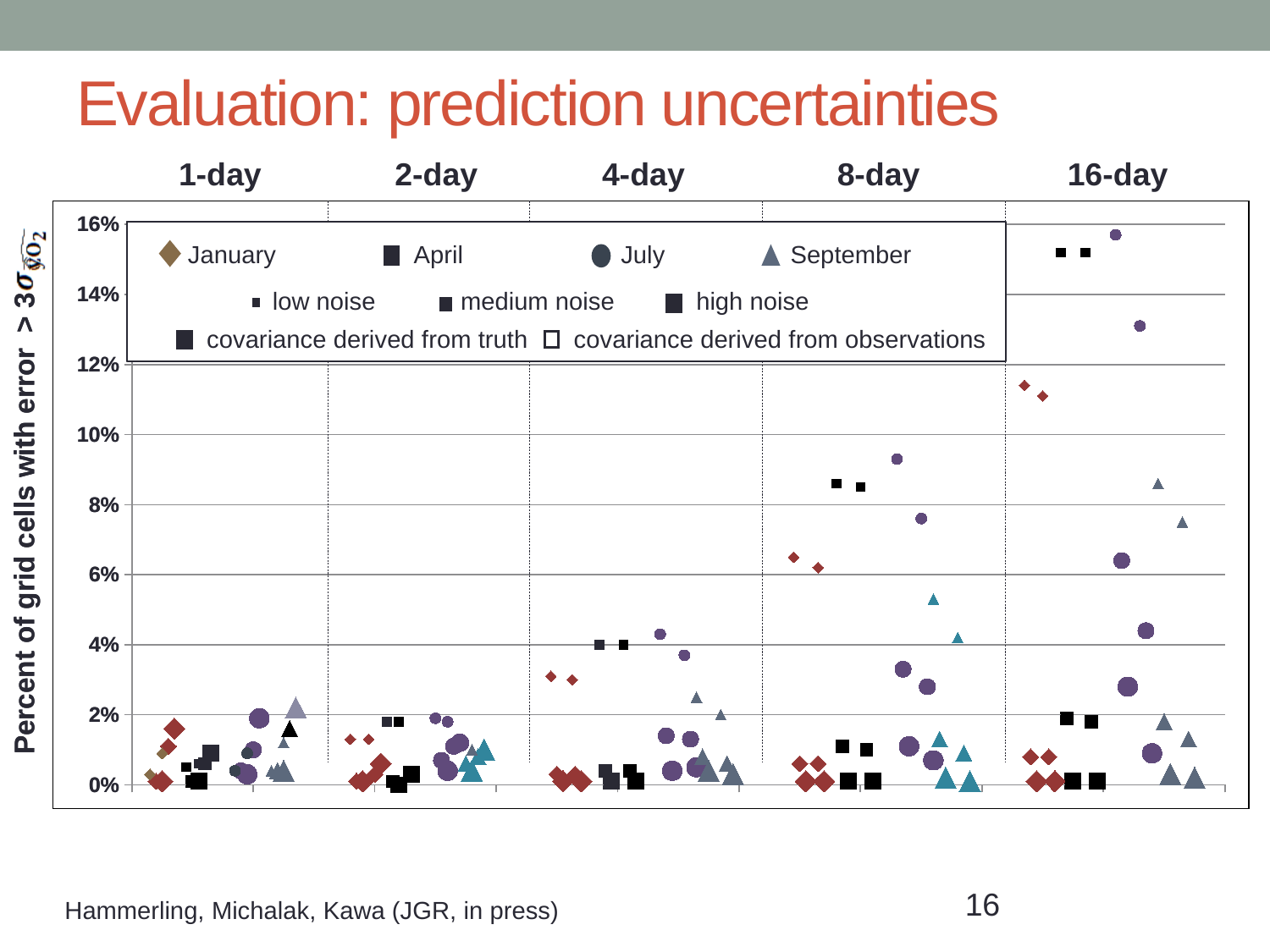
Is the highest point in the 8-day group greater or less than 8%? greater What kind of chart is shown on the slide? scatter chart How many months does the chart legend list? 4 Is the highest point in the 16-day group greater or less than 14%? greater Are all the points in the 2-day group greater or less than 4%? less Which marker shape does the legend use for September? triangle What is the highest value shown on the y axis? 16% Which forecast-length group contains the highest plotted point? 16-day Which group has the higher maximum point, 8-day or 16-day? 16-day How many forecast-length groups are labelled along the top of the chart? 5